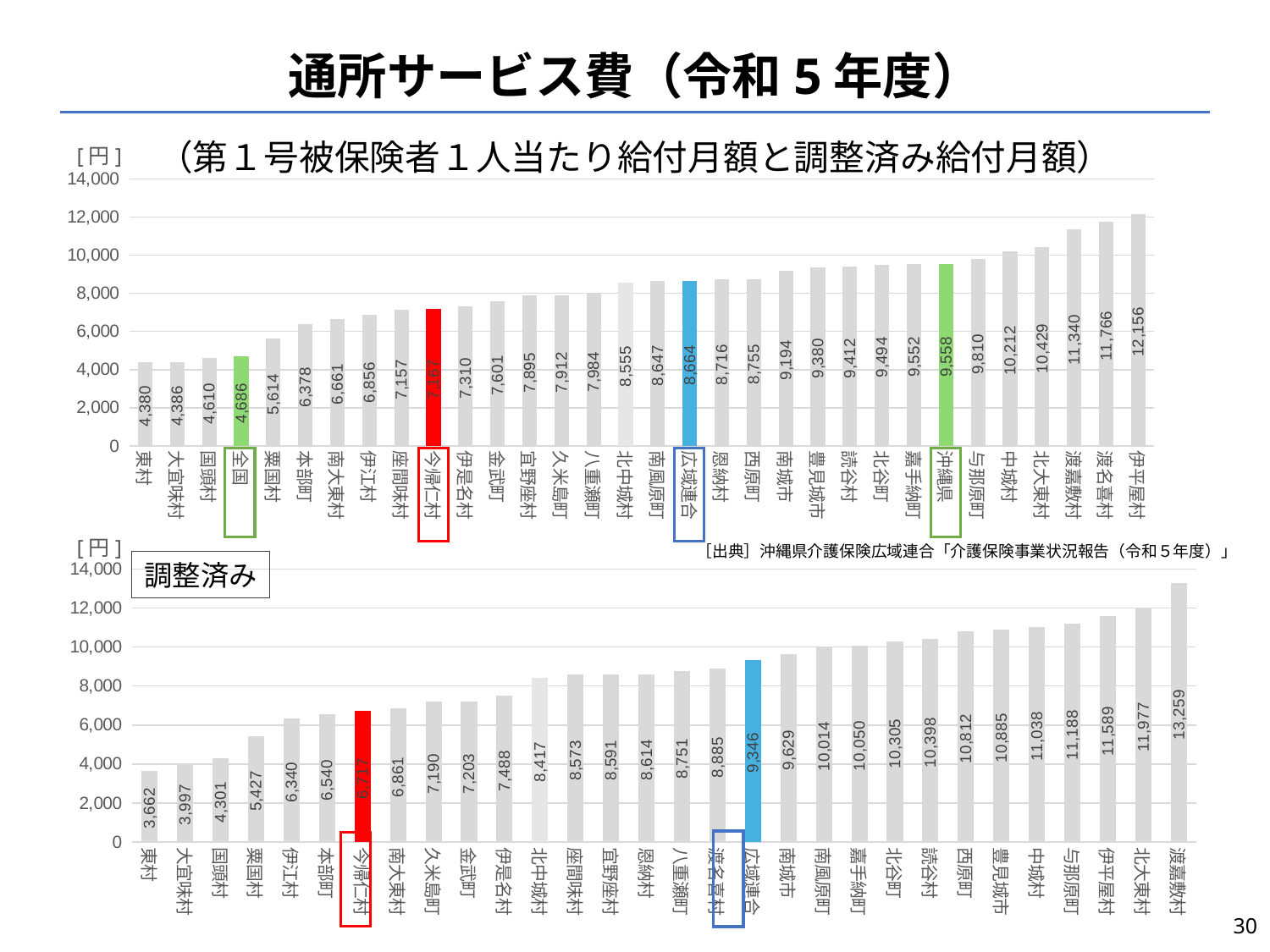
In the top chart, what is the value for 今帰仁村? 7,167 In the top chart, what is the difference between 沖縄県 and 全国? 4,872 In the top chart, which category has the lowest value? 東村 In the bottom chart (調整済み), is the value for 渡名喜村 greater or less than 10,000? less In the top chart, what is the value for 沖縄県? 9,558 In the bottom chart (調整済み), which category has the highest value? 渡嘉敷村 How many categories are plotted in the bottom chart (調整済み)? 30 In the top chart, which is larger, the value for 広域連合 or the value for 南城市? 南城市 In the bottom chart (調整済み), what is the value for 広域連合? 9,346 What type of chart is the top chart? bar chart In the top chart, which category has the highest value? 伊平屋村 In the bottom chart (調整済み), what is the difference between 広域連合 and 今帰仁村? 2,629